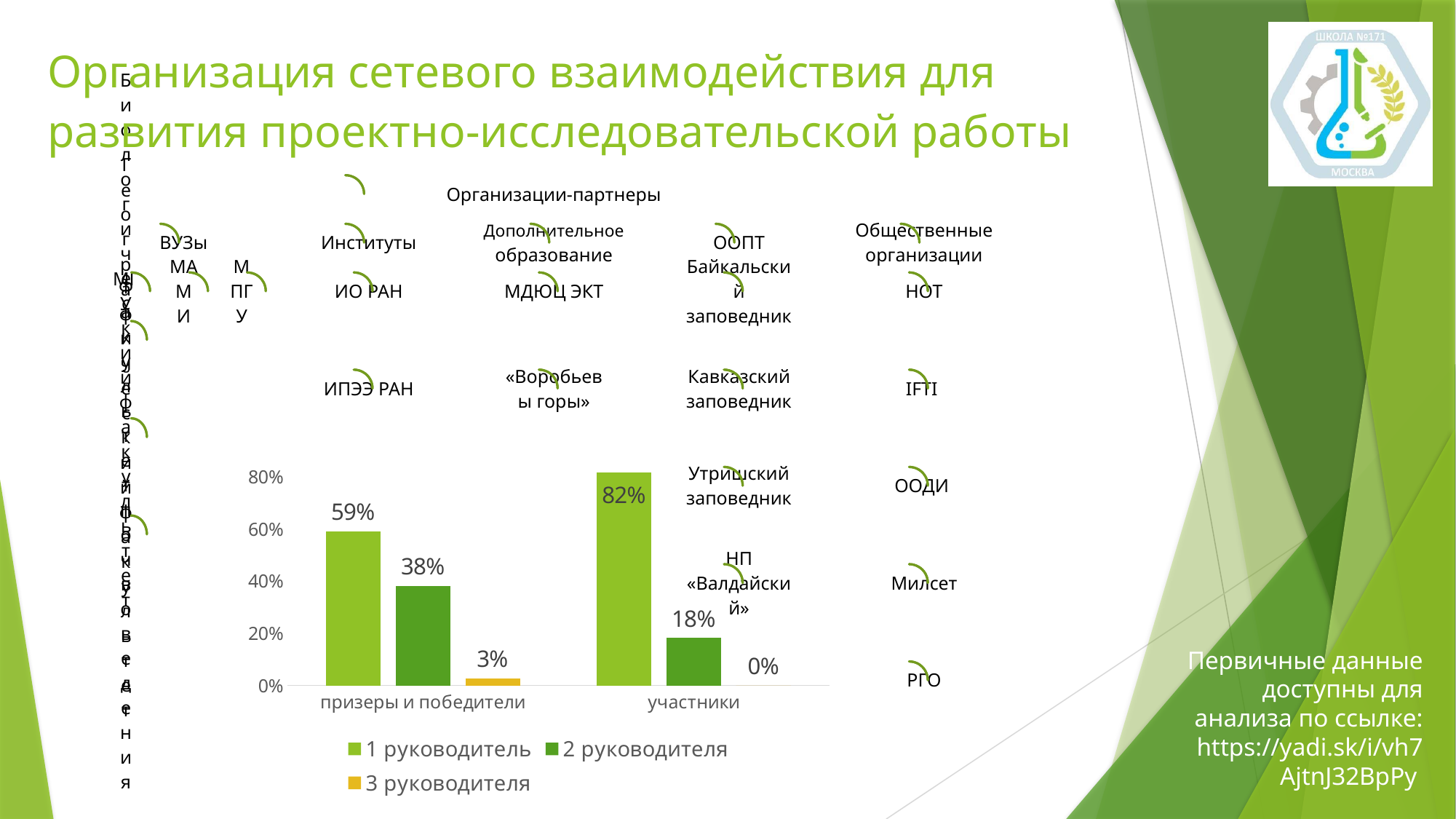
Which category has the highest value for '1 руководитель'? участники What percentage is shown for '1 руководитель' in the 'участники' category? 82% Which series has the lowest value in the 'призеры и победители' category? 3 руководителя How many categories are shown on the x axis of the bar chart? 2 Which is larger: '2 руководителя' for 'призеры и победители' or '2 руководителя' for 'участники'? призеры и победители What percentage is shown for '2 руководителя' in the 'участники' category? 18% How many series does the chart legend list? 3 What percentage is shown for '3 руководителя' in the 'участники' category? 0% What percentage is shown for '3 руководителя' in the 'призеры и победители' category? 3% What kind of chart is shown on the slide? bar chart What percentage is shown for '1 руководитель' in the 'призеры и победители' category? 59% What is the difference between the '1 руководитель' values for 'участники' and 'призеры и победители'? 23%